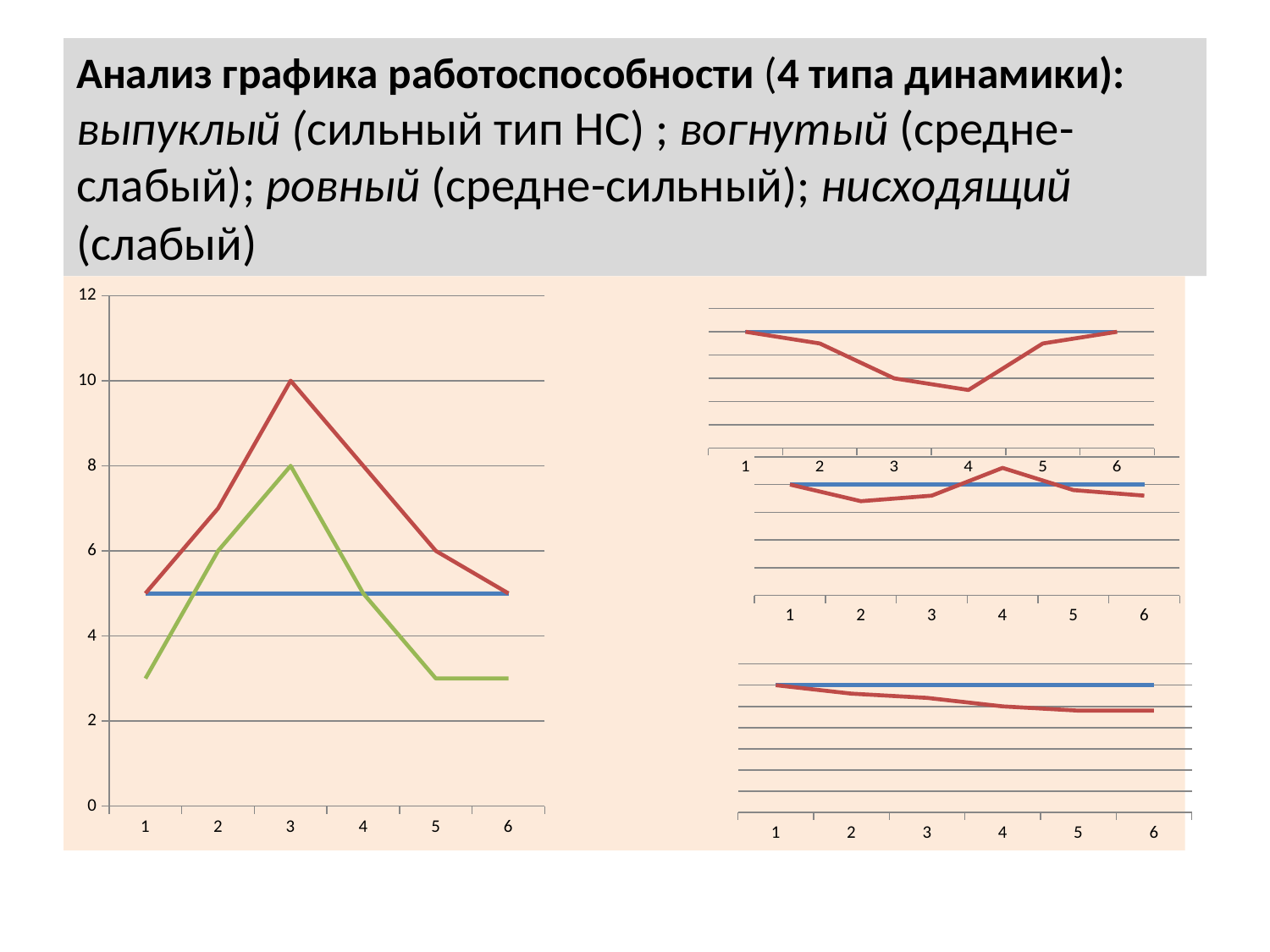
In the large chart on the left, at which x value does the red line reach its highest point? 3 In the large chart on the left, what is the value of the red line at x = 4? 8 In the large chart on the left, what is the value of the green line at x = 2? 6 In the large chart on the left, what is the difference between the red line at x = 3 and the red line at x = 5? 4 In the large chart on the left, what is the value of the red line at x = 3? 10 In the bottom-right chart, does the red line rise or fall from x = 1 to x = 6? fall In the large chart on the left, what is the value of the green line at x = 3? 8 In the large chart on the left, is the value of the green line at x = 1 greater or less than 4? less How many x-axis points does the large chart on the left have? 6 In the large chart on the left, which is larger at x = 4: the red line or the green line? the red line What kind of chart is the large chart on the left of the slide? line chart How many charts are shown on the slide? 4